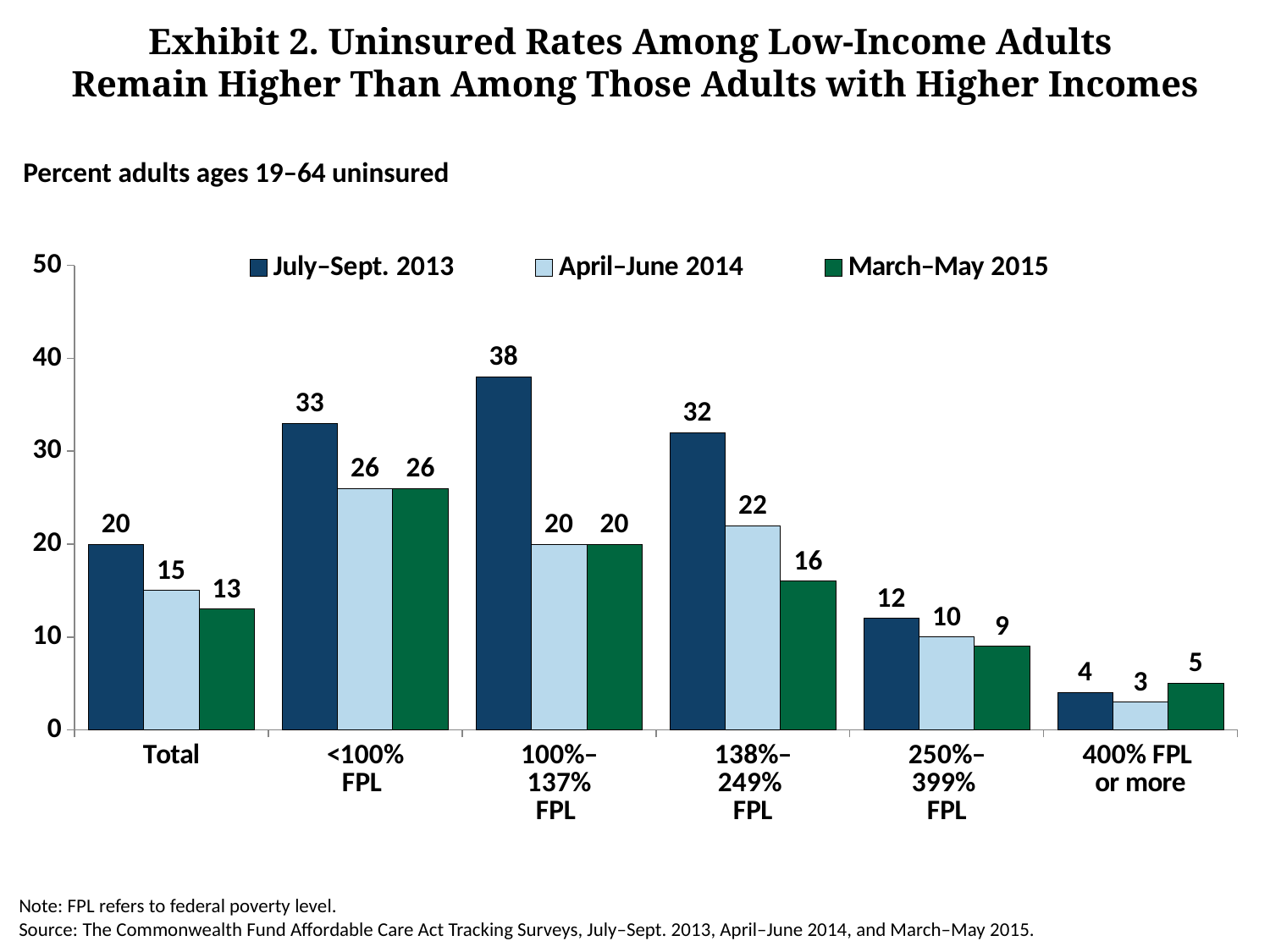
What kind of chart is shown on the slide? Bar chart Which income category has the lowest uninsured rate in March–May 2015? 400% FPL or more Which is larger for adults at <100% FPL: the April–June 2014 rate or the July–Sept. 2013 rate? July–Sept. 2013 What is the uninsured rate for adults at 400% FPL or more in April–June 2014? 3 Which survey period is shown in dark blue in the legend? July–Sept. 2013 What is the uninsured rate for the Total category in July–Sept. 2013? 20 Is the July–Sept. 2013 value for 100%–137% FPL greater or less than 30? greater What is the uninsured rate for adults at 100%–137% FPL in March–May 2015? 20 Which income category has the highest uninsured rate in July–Sept. 2013? 100%–137% FPL What is the difference between the July–Sept. 2013 and March–May 2015 uninsured rates for adults at 138%–249% FPL? 16 How many income categories are shown on the x axis? 6 How many series does the legend list? 3